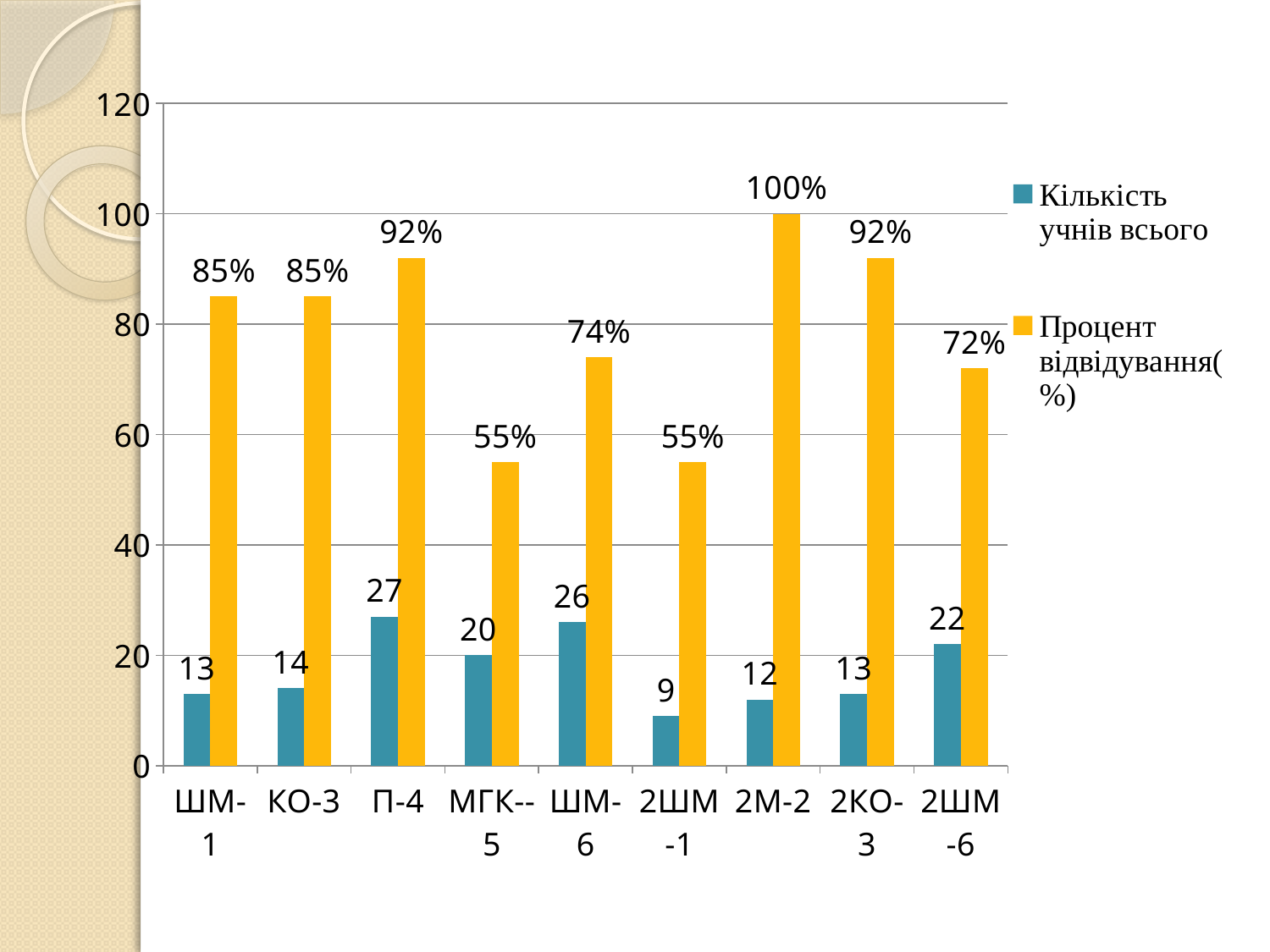
What is the value of "Процент відвідування(%)" for МГК--5? 55% How many categories are shown on the x axis? 9 What is the value of "Кількість учнів всього" for П-4? 27 How many series does the legend list? 2 Which category has the highest value for "Процент відвідування(%)"? 2М-2 Is the "Процент відвідування(%)" value for 2КО-3 greater or less than 80? greater What is the difference between the "Кількість учнів всього" values for ШМ-6 and 2ШМ-6? 4 What colour are the bars for the "Процент відвідування(%)" series? yellow Which is larger: the "Процент відвідування(%)" value for ШМ-6 or for 2ШМ-6? ШМ-6 Which category has the lowest value for "Кількість учнів всього"? 2ШМ-1 What kind of chart is shown on the slide? bar chart What is the value of "Процент відвідування(%)" for 2М-2? 100%